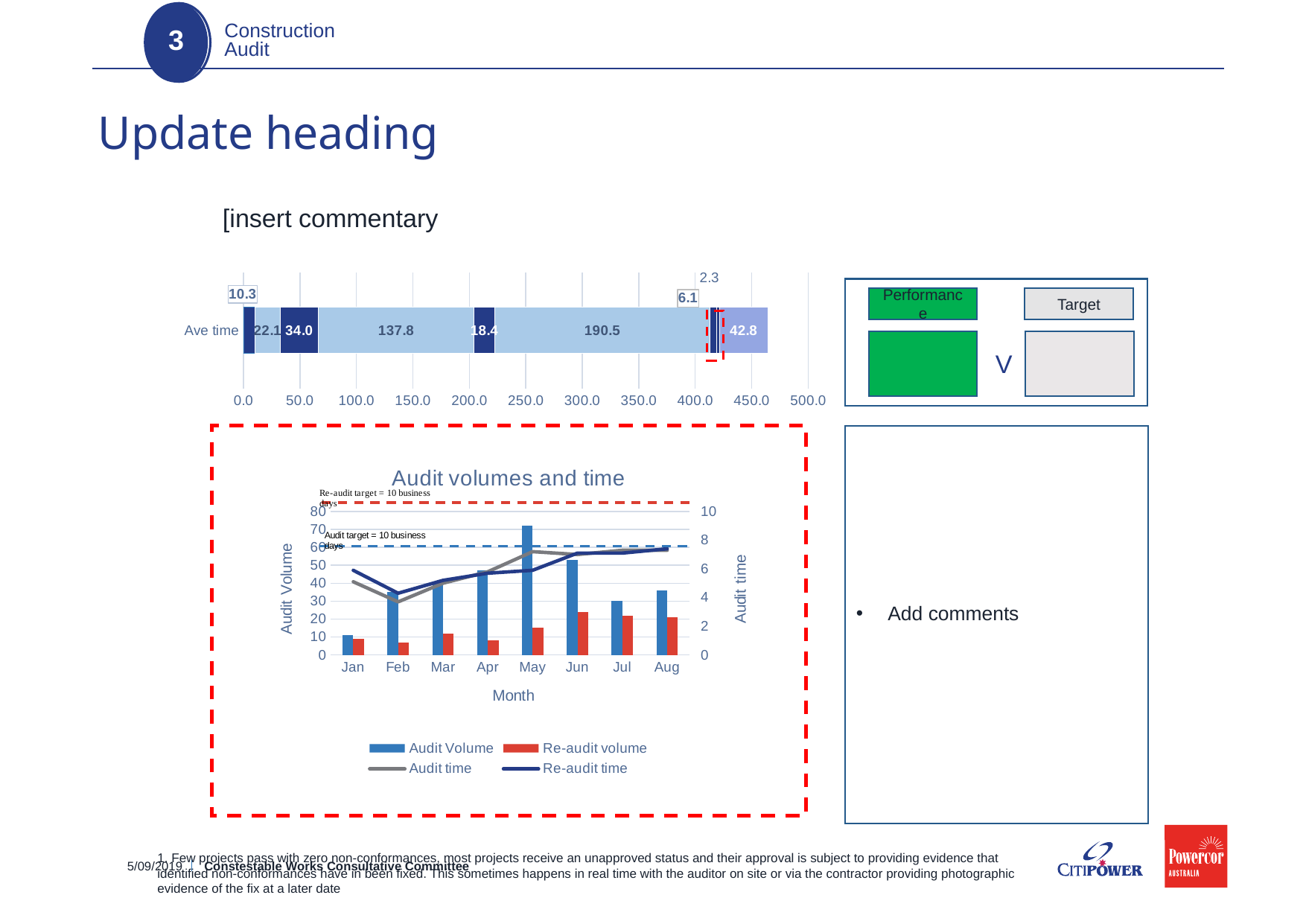
In the 'Audit volumes and time' chart, how many series does the legend list? 4 In the 'Audit volumes and time' chart, which month has the lowest Audit Volume? Jan In the 'Audit volumes and time' chart, which month has the highest Audit Volume? May What kind of chart is the top 'Ave time' chart? Stacked horizontal bar chart In the top 'Ave time' chart, what is the difference between the 190.5 segment and the 137.8 segment? 52.7 In the top 'Ave time' chart, what is the value of the largest segment of the stacked bar? 190.5 In the 'Audit volumes and time' chart, does the Re-audit time line generally rise or fall from Feb to Aug? rise In the 'Audit volumes and time' chart, is the Audit Volume for Jan greater or less than 20? less In the 'Audit volumes and time' chart, which month has the highest Re-audit volume? Jun In the 'Audit volumes and time' chart, which is larger: the Audit Volume for Apr or for May? May In the 'Audit volumes and time' chart, how many months are shown on the x axis? 8 In the 'Audit volumes and time' chart, is the Audit Volume for May greater or less than 60? greater